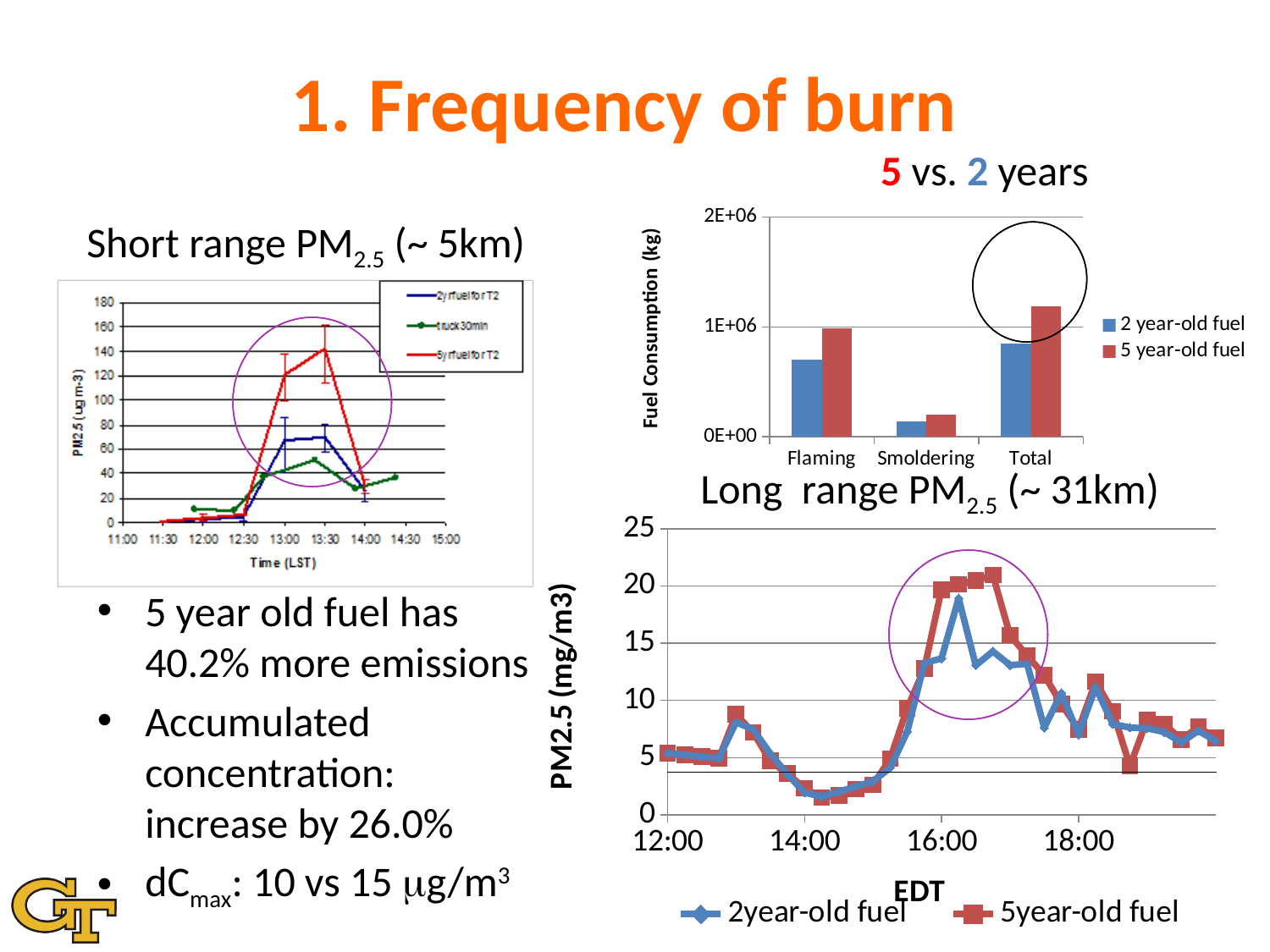
In the Fuel Consumption bar chart, which category and series has the tallest bar? Total, 5 year-old fuel In the Fuel Consumption bar chart, is the Flaming value for 2 year-old fuel greater or less than 1E+06? less What kind of chart is the Fuel Consumption chart at the top right? bar chart In the Long range PM2.5 (~ 31km) chart, which series reaches the higher peak: 2year-old fuel or 5year-old fuel? 5year-old fuel In the Short range PM2.5 (~ 5km) chart, how many series does the legend list? 3 In the Fuel Consumption bar chart, is the Total value for 5 year-old fuel greater or less than 1E+06? greater In the Fuel Consumption bar chart, for the Total category, which series has the larger bar: 2 year-old fuel or 5 year-old fuel? 5 year-old fuel In the Fuel Consumption bar chart, which category has the lowest bars? Smoldering In the Fuel Consumption bar chart, how many series does the legend list? 2 In the Long range PM2.5 (~ 31km) chart, is the peak value of the 5year-old fuel series greater or less than 20? greater In the Fuel Consumption bar chart, how many categories are shown on the x axis? 3 What kind of chart is the Long range PM2.5 (~ 31km) chart? line chart